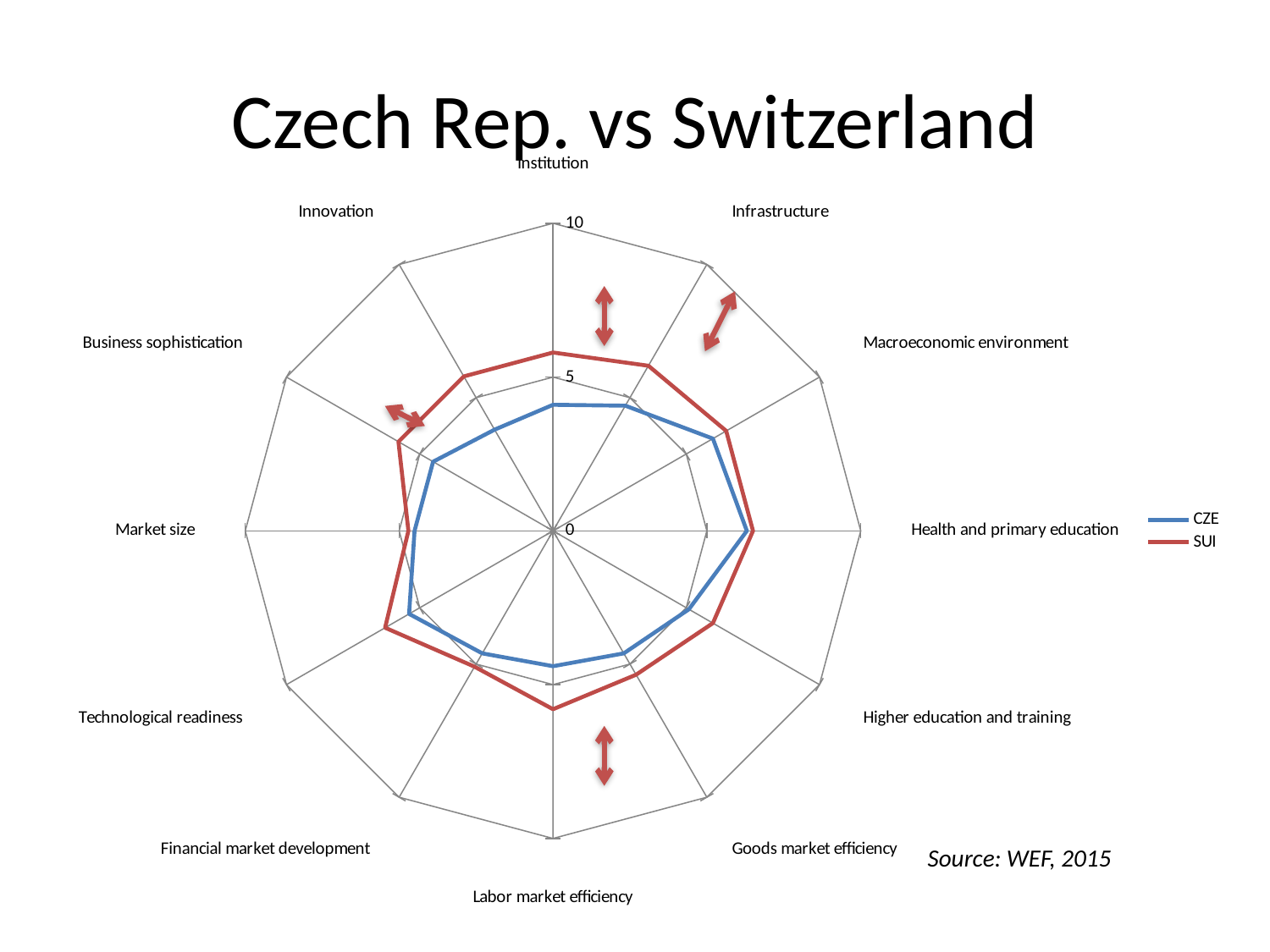
Which series is drawn in red? SUI How many series does the legend list? 2 Is the CZE value for Health and primary education greater or less than 5? greater What is the title of the slide? Czech Rep. vs Switzerland Is the CZE value for Institution greater or less than 5? less For Institution, which series has the larger value, CZE or SUI? SUI How many categories (axes) does the radar chart have? 12 For Labor market efficiency, which series has the larger value, CZE or SUI? SUI Is the SUI value for Institution greater or less than 5? greater What kind of chart is shown on the slide? Radar chart